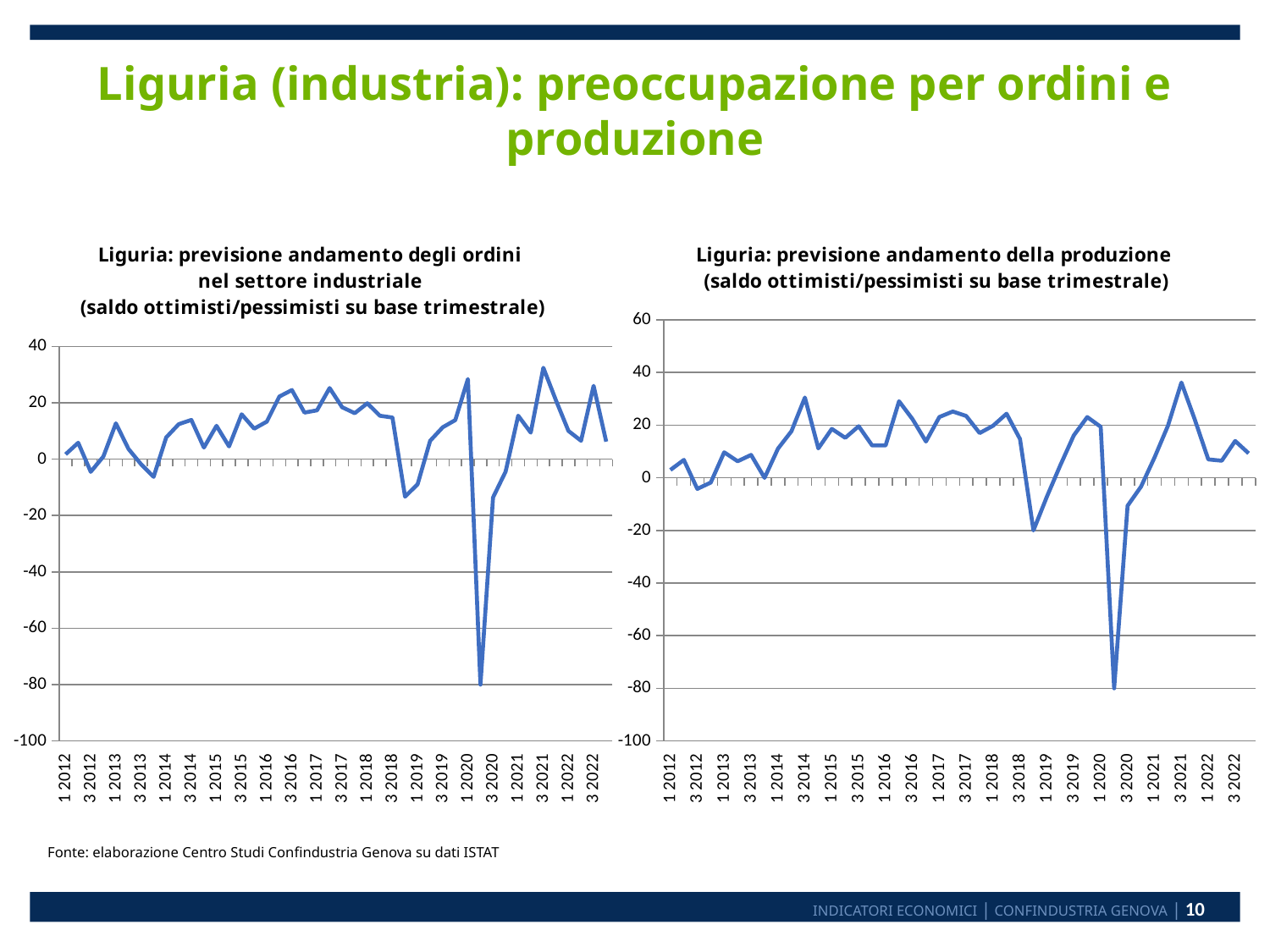
In the right chart (previsione andamento della produzione), which is larger, the value for 3 2021 or the value for 1 2022? 3 2021 What is the highest value shown on the vertical axis of the right chart (previsione andamento della produzione)? 60 In the right chart (previsione andamento della produzione), is the value for 3 2020 greater or less than 0? less In the left chart (previsione andamento degli ordini), in which year does the lowest value occur? 2020 In the right chart (previsione andamento della produzione), do the values rise or fall between 3 2020 and 3 2021? rise In the left chart (previsione andamento degli ordini), which is larger, the value for 3 2021 or the value for 1 2022? 3 2021 What kind of chart is the left chart, 'Liguria: previsione andamento degli ordini nel settore industriale'? line chart What kind of chart is the right chart, 'Liguria: previsione andamento della produzione'? line chart In the left chart (previsione andamento degli ordini), is the value for 3 2021 greater or less than 20? greater In the right chart (previsione andamento della produzione), is the value for 3 2021 greater or less than 20? greater In the right chart (previsione andamento della produzione), in which year does the lowest value occur? 2020